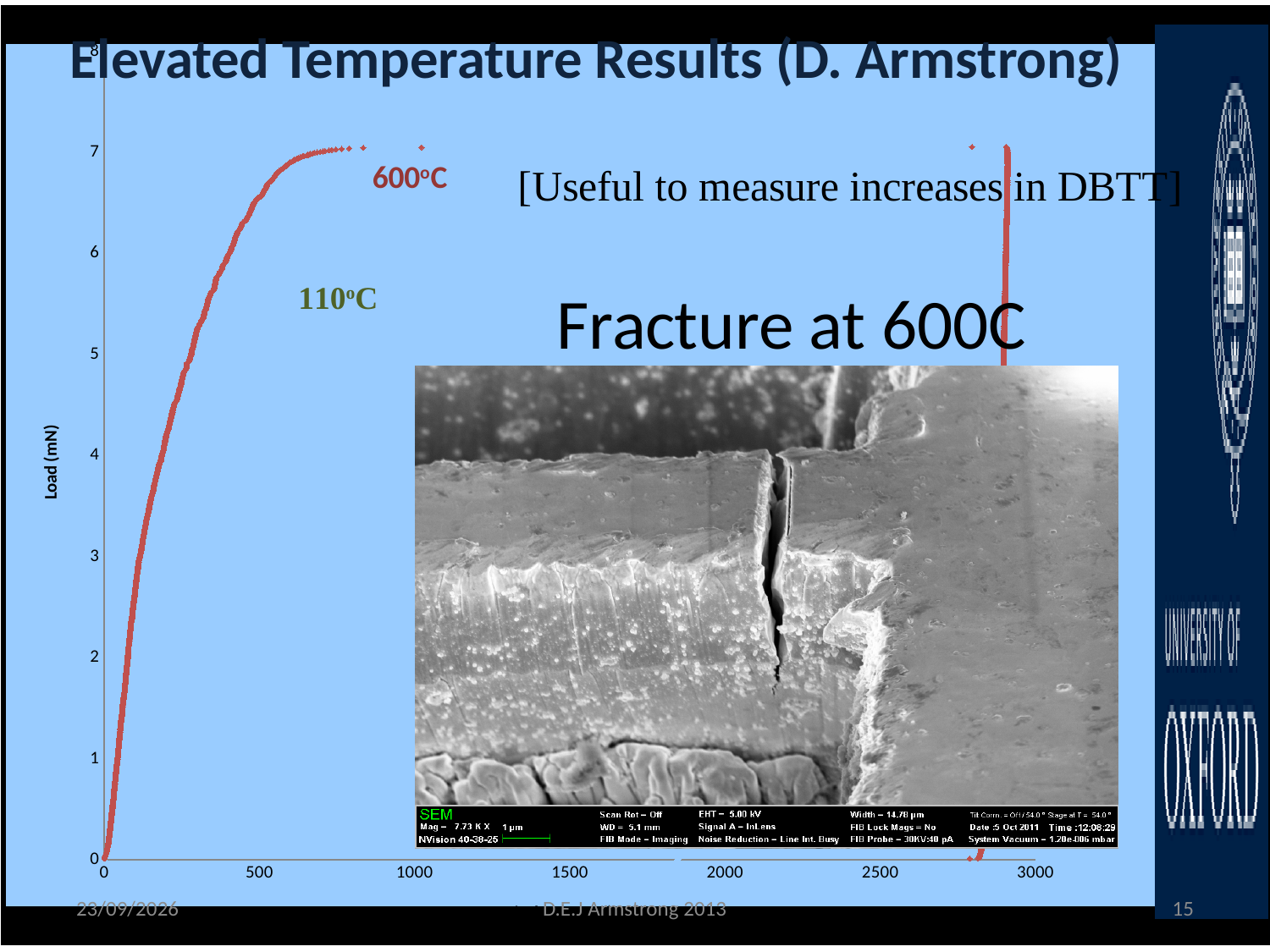
How many temperature conditions are labelled on the chart? 2 Does the load rise or fall as the x-axis value increases from 0 along the main curve? rise What kind of chart is shown on the slide? scatter (line) chart What is the spacing between consecutive tick marks on the y axis? 1 Is the plateau load reached by the curve greater or less than 6 mN? greater What is the highest tick value shown on the x axis of the chart? 3000 Is the plateau load reached by the curve greater or less than 8 mN? less Which two temperatures are labelled on the chart? 600°C and 110°C What is the spacing between consecutive tick marks on the x axis? 500 What is the lowest tick value shown on the y axis of the chart? 0 What is the label on the y axis of the chart? Load (mN) What is the highest tick value shown on the y axis of the chart? 8